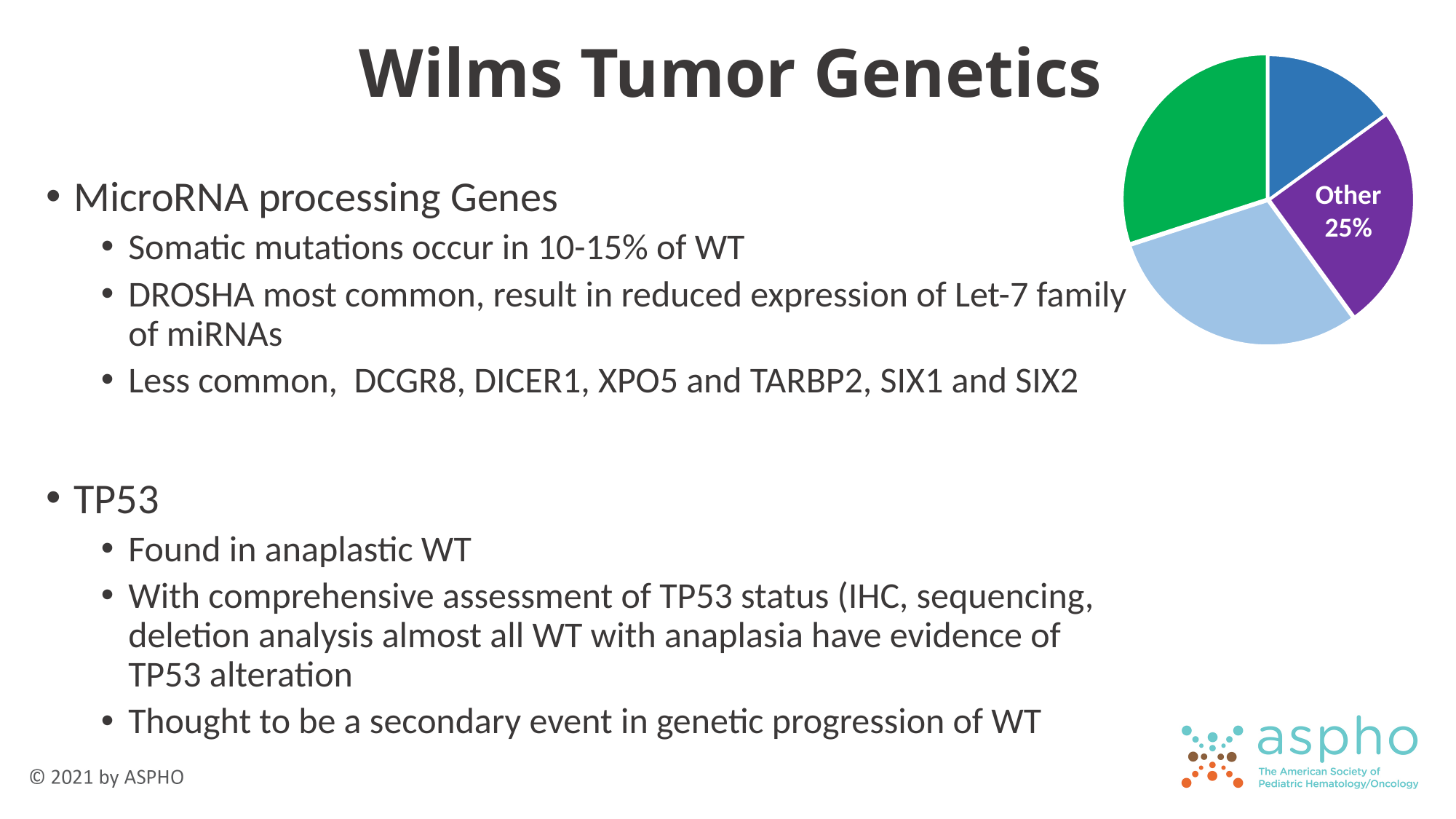
What share of the pie does the Other slice represent? 25% Which slice of the pie chart is the only one with a data label? Other What percentage is shown for the Other slice of the pie chart? 25% How many slices does the pie chart have? 4 What colour is the Other slice in the pie chart? purple What kind of chart is shown on the slide? pie chart